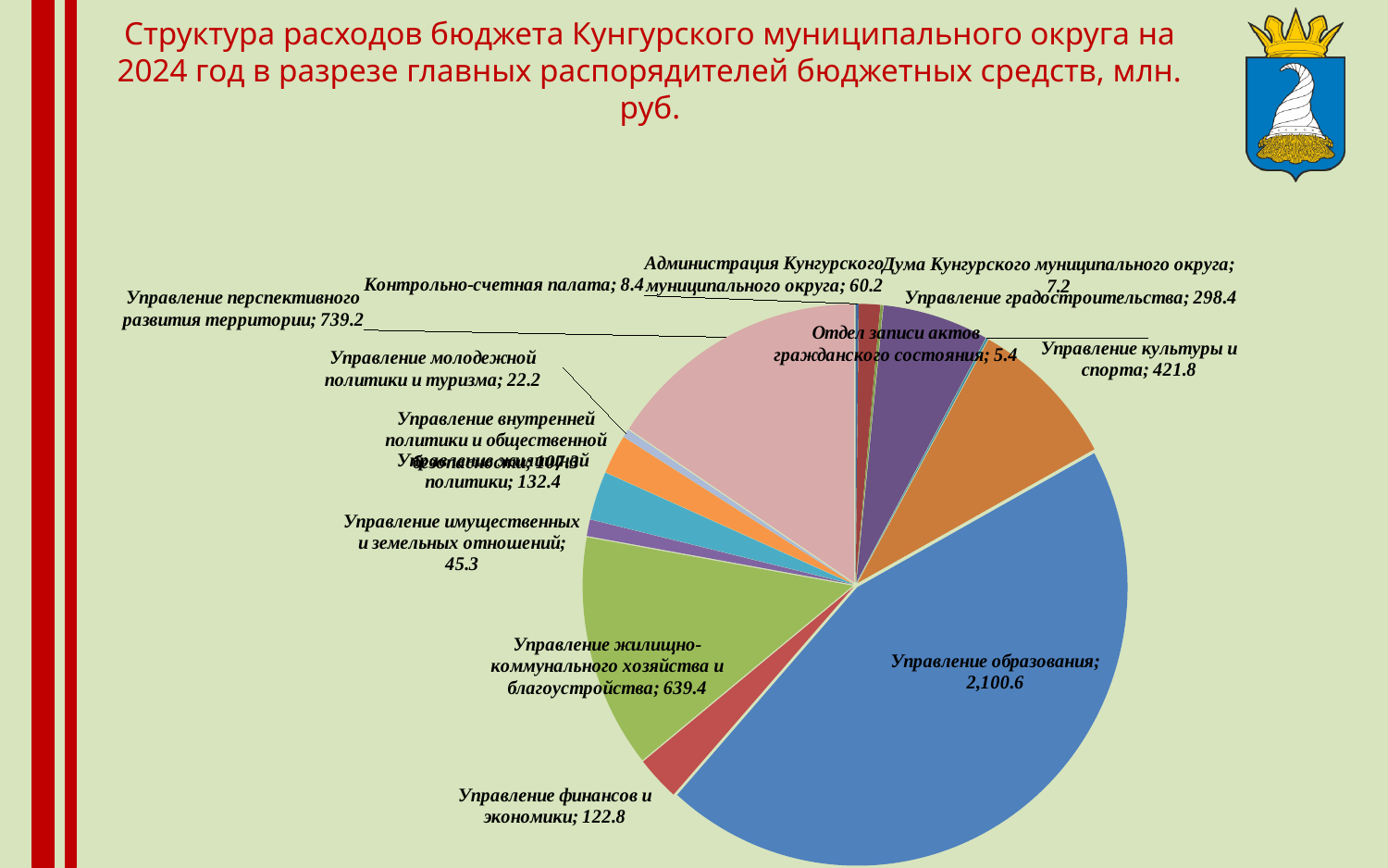
Which category has the largest slice of the pie? Управление образования What kind of chart is shown on the slide? pie chart What year does the chart title say the budget expenditure structure refers to? 2024 What is the difference between the values for Администрация Кунгурского муниципального округа and Дума Кунгурского муниципального округа? 53.0 What is the value for Управление образования? 2,100.6 Which category has the smallest value in the chart? Отдел записи актов гражданского состояния What is the value for Управление финансов и экономики? 122.8 Which is larger: Управление градостроительства or Управление культуры и спорта? Управление культуры и спорта What is the value for Управление культуры и спорта? 421.8 What is the difference between the values for Управление перспективного развития территории and Управление жилищно-коммунального хозяйства и благоустройства? 99.8 What is the value for Контрольно-счетная палата? 8.4 What is the value for Управление имущественных и земельных отношений? 45.3